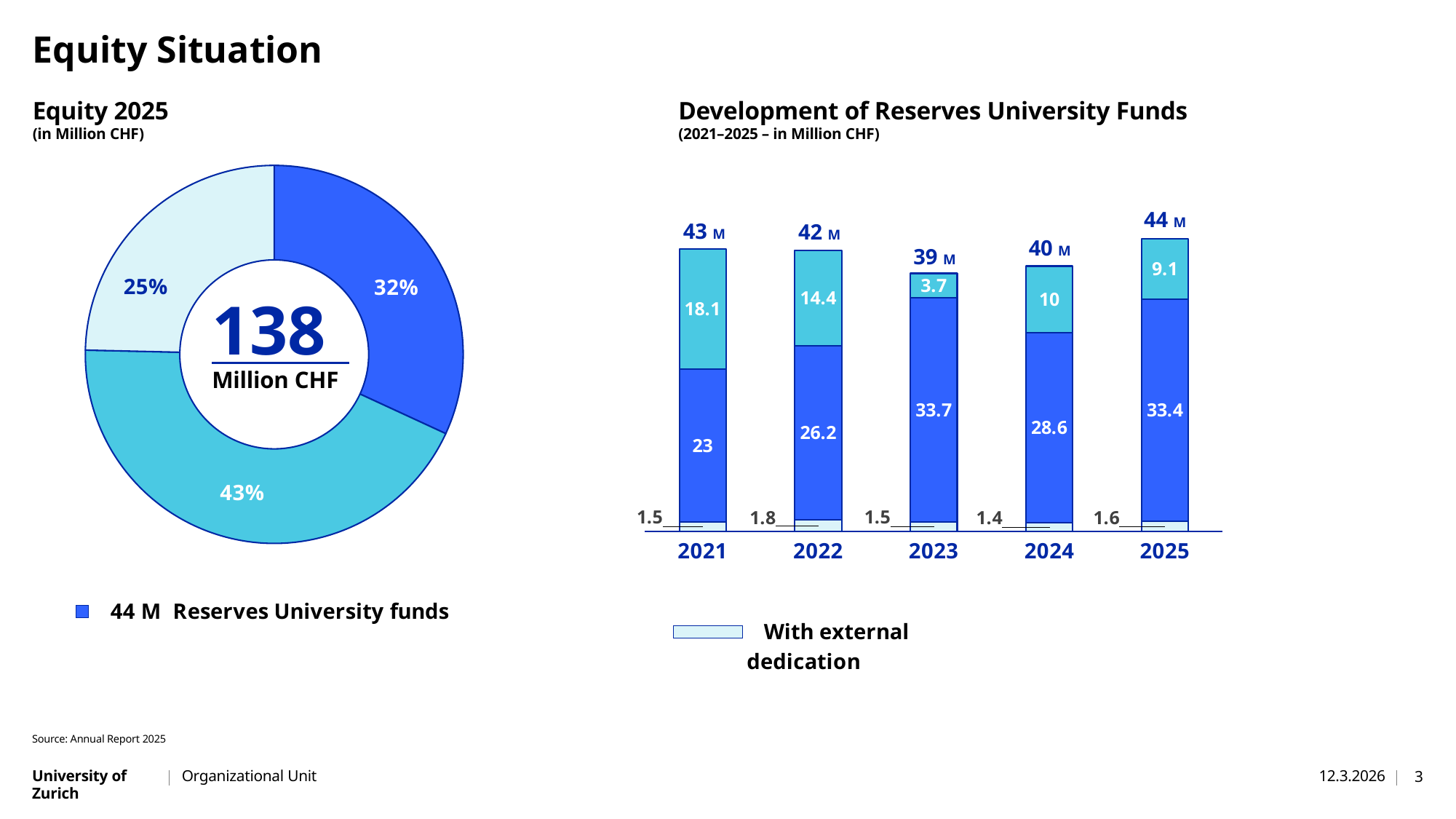
In the Development of Reserves University Funds chart, which year has the lowest total? 2023 In the Development of Reserves University Funds chart, which year has the highest total? 2025 In the Development of Reserves University Funds chart, what is the total for 2025? 44 M In the Development of Reserves University Funds chart, what is the difference between the totals for 2025 and 2023? 5 M In the Equity 2025 chart, what is the largest slice's share? 43% What kind of chart is the Development of Reserves University Funds chart? stacked bar chart In the Development of Reserves University Funds chart, what is the total for 2023? 39 M In the Development of Reserves University Funds chart, what is the value with external dedication for 2022? 1.8 In the Development of Reserves University Funds chart, is the total for 2021 larger or smaller than the total for 2022? larger How many years are shown in the Development of Reserves University Funds chart? 5 What total value is shown in the centre of the Equity 2025 chart? 138 Million CHF In the Development of Reserves University Funds chart, what is the value with external dedication for 2024? 1.4